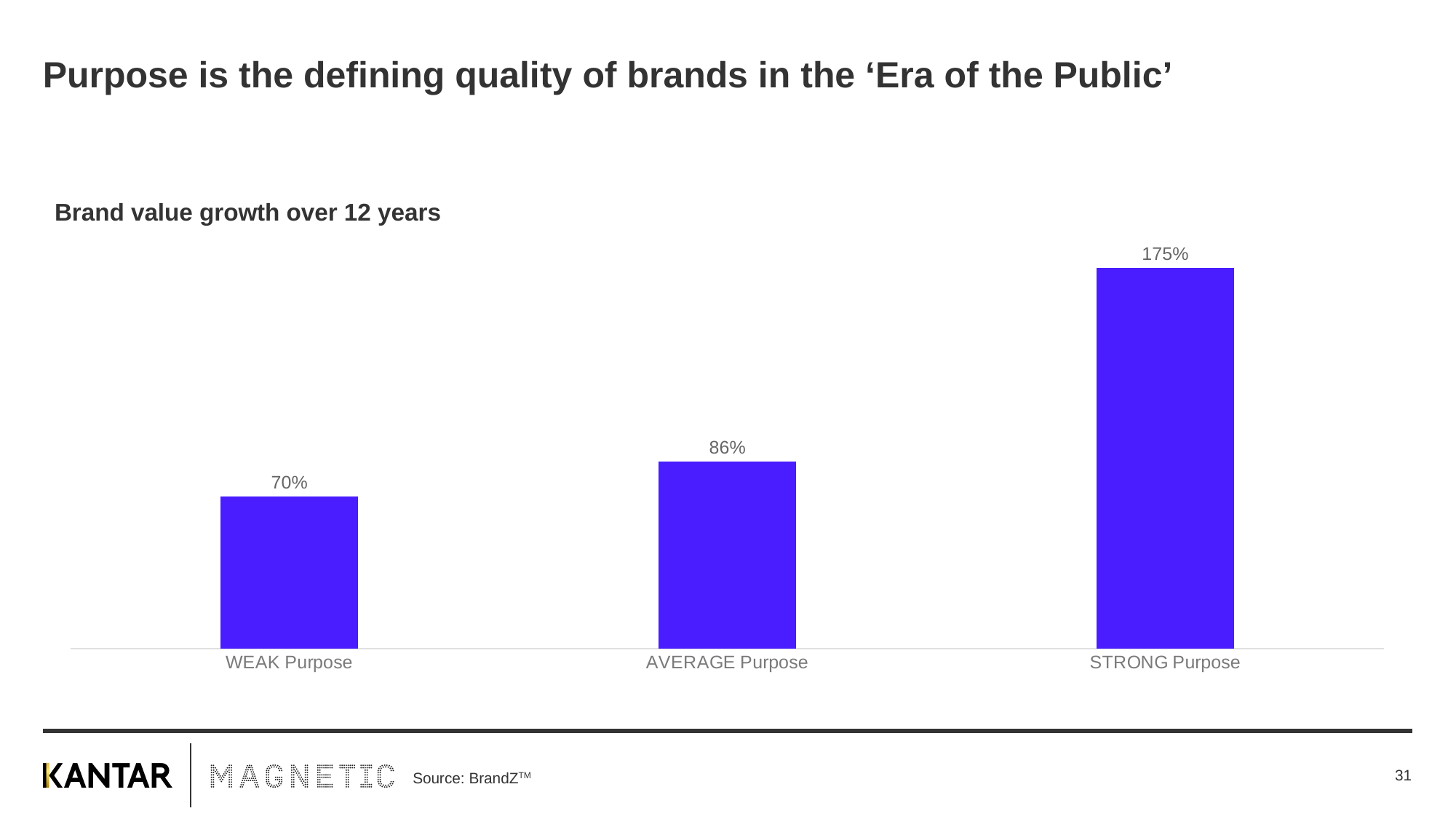
How many categories are shown in the chart? 3 What kind of chart is shown on the slide? Bar chart What is the difference in brand value growth between STRONG Purpose and WEAK Purpose brands? 105% What is the brand value growth over 12 years for STRONG Purpose brands? 175% Which has higher brand value growth, AVERAGE Purpose or STRONG Purpose? STRONG Purpose What is the title of the chart? Brand value growth over 12 years Which category shows the highest brand value growth? STRONG Purpose What is the brand value growth over 12 years for WEAK Purpose brands? 70% Do the values rise or fall moving from WEAK Purpose to STRONG Purpose? Rise Which category shows the lowest brand value growth? WEAK Purpose What is the difference in brand value growth between AVERAGE Purpose and WEAK Purpose brands? 16% What is the brand value growth over 12 years for AVERAGE Purpose brands? 86%